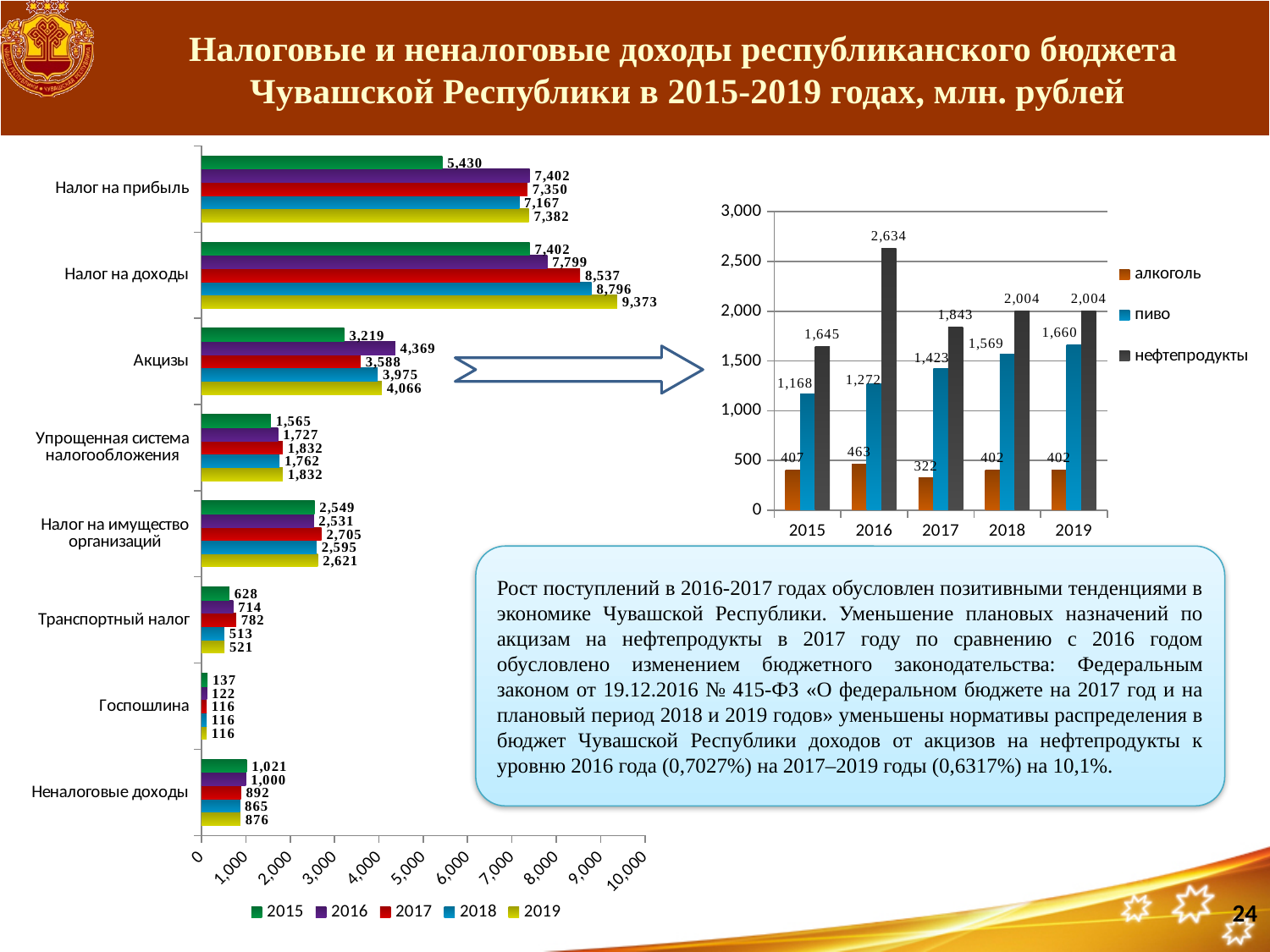
In the right chart, what is the value for нефтепродукты in 2016? 2,634 In the left chart, how many series does the legend list? 5 In the right chart, what is the difference between the нефтепродукты values for 2016 and 2017? 791 In the left chart, what is the value for Налог на доходы in 2019? 9,373 In the right chart, which year has the highest value for пиво? 2019 In the left chart, what is the difference between the 2019 and 2015 values for Налог на доходы? 1,971 In the left chart, is the 2017 value for Транспортный налог larger or smaller than the 2018 value? larger In the left chart, how many categories are shown on the vertical axis? 8 What type of chart is the right chart? bar chart In the left chart, what is the value for Акцизы in 2016? 4,369 In the left chart, which year has the lowest value for Налог на прибыль? 2015 In the right chart, do the values for пиво rise or fall from 2015 to 2019? rise